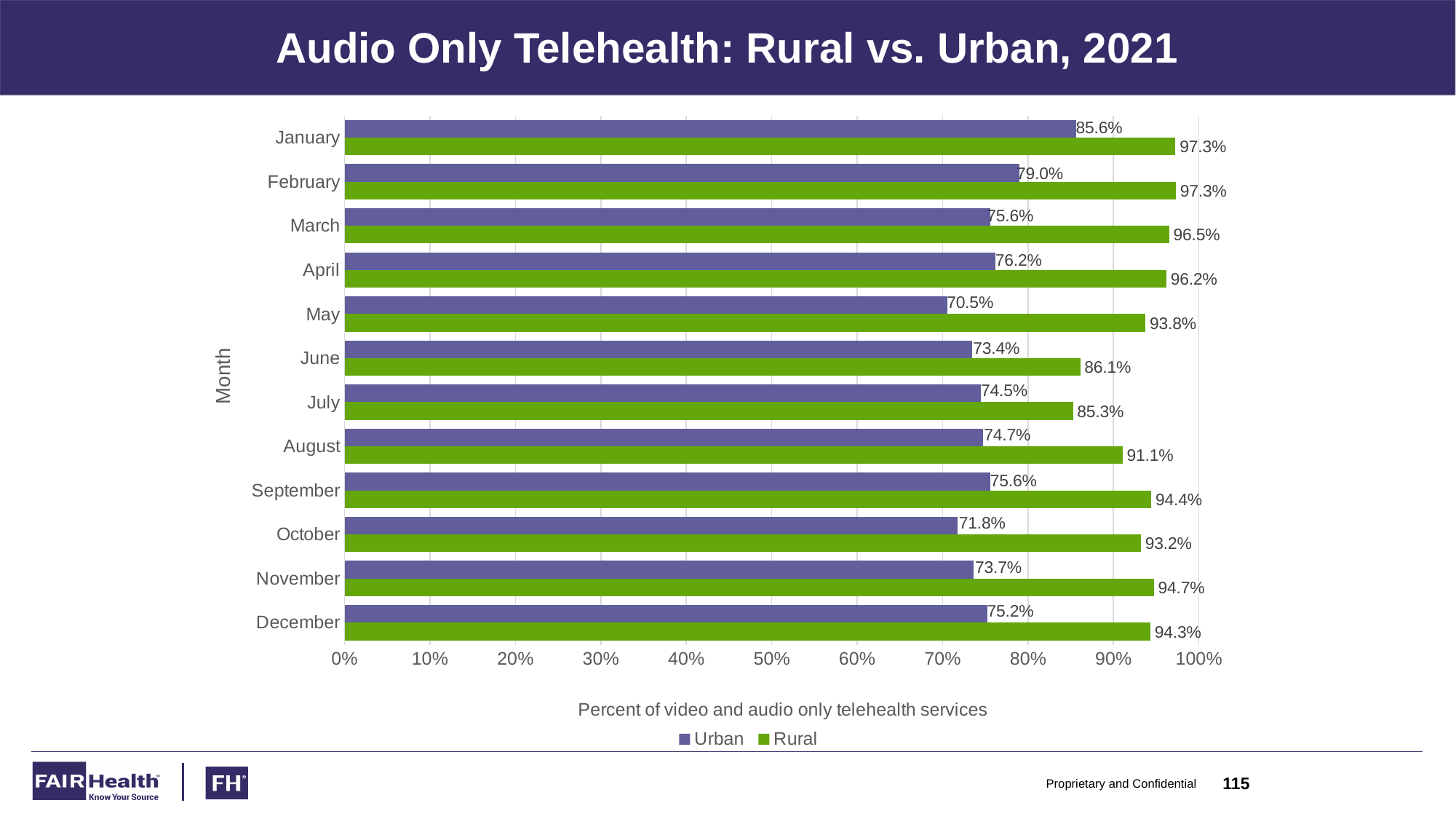
Which month has the highest Urban value? January Is the Rural value for August greater or less than 90%? greater How many months are shown on the chart? 12 What is the difference between the Rural and Urban values for May? 23.3% What is the Rural value for June? 86.1% What is the Urban value for October? 71.8% Which month has the lowest Urban value? May What kind of chart is shown on the slide? Bar chart Which month has the lowest Rural value? July What is the Urban value for January? 85.6% Which is larger, the Urban value for February or the Urban value for December? February How many series does the legend list? 2